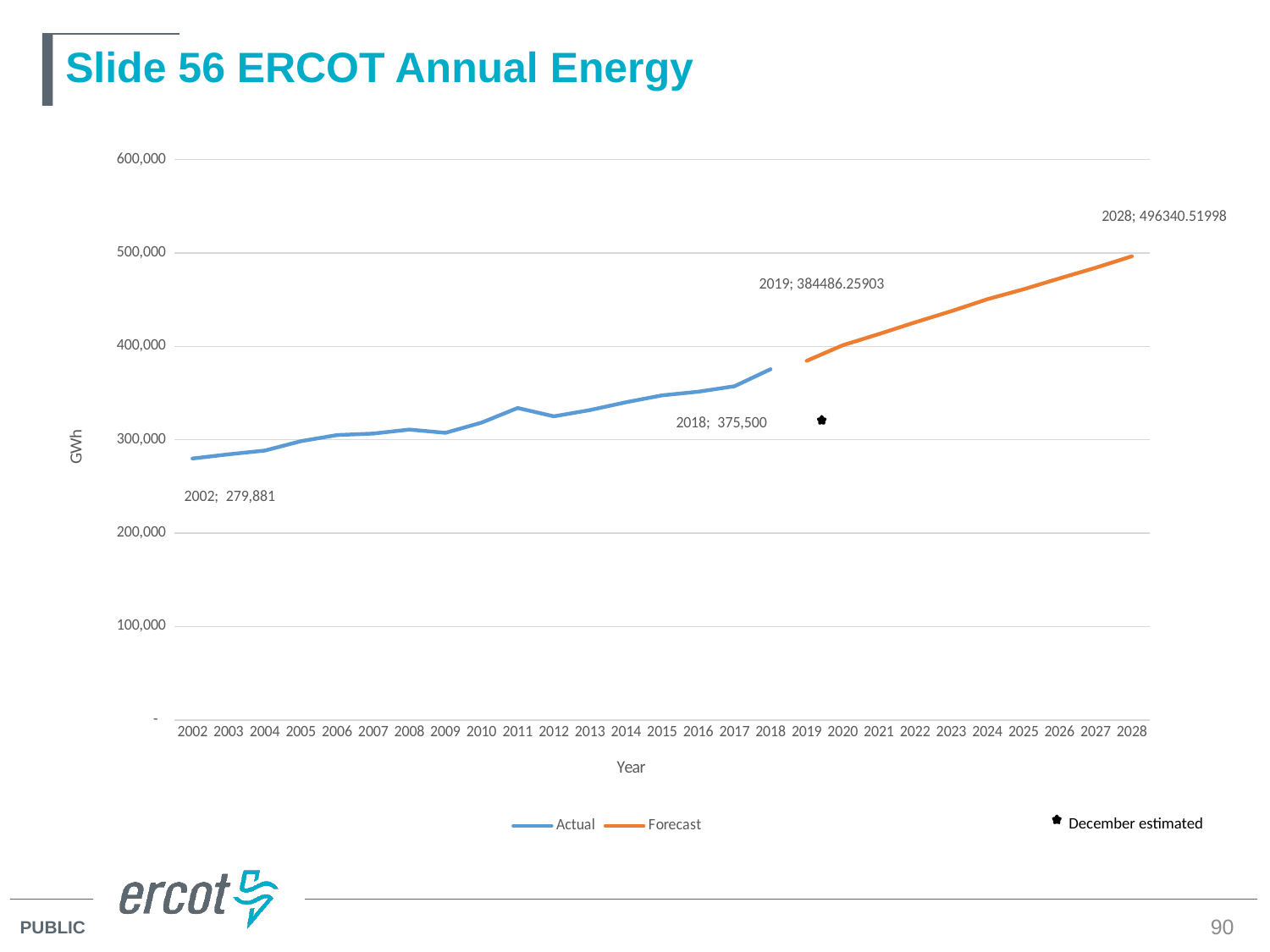
Does the Forecast line rise or fall from 2019 to 2028? rise What is the Actual value for 2002? 279,881 Is the Forecast value for 2024 greater or less than 500,000? less What is the Forecast value for 2028? 496340.51998 What is the Forecast value for 2019? 384486.25903 What type of chart is shown on the slide? line chart What is the Actual value for 2018? 375,500 Is the Actual value for 2011 greater or less than 300,000? greater How many years are shown on the x axis? 27 How many series does the chart legend list? 2 What is the difference between the Actual values for 2018 and 2002? 95,619 Which is larger, the Forecast value for 2028 or the Actual value for 2018? Forecast value for 2028